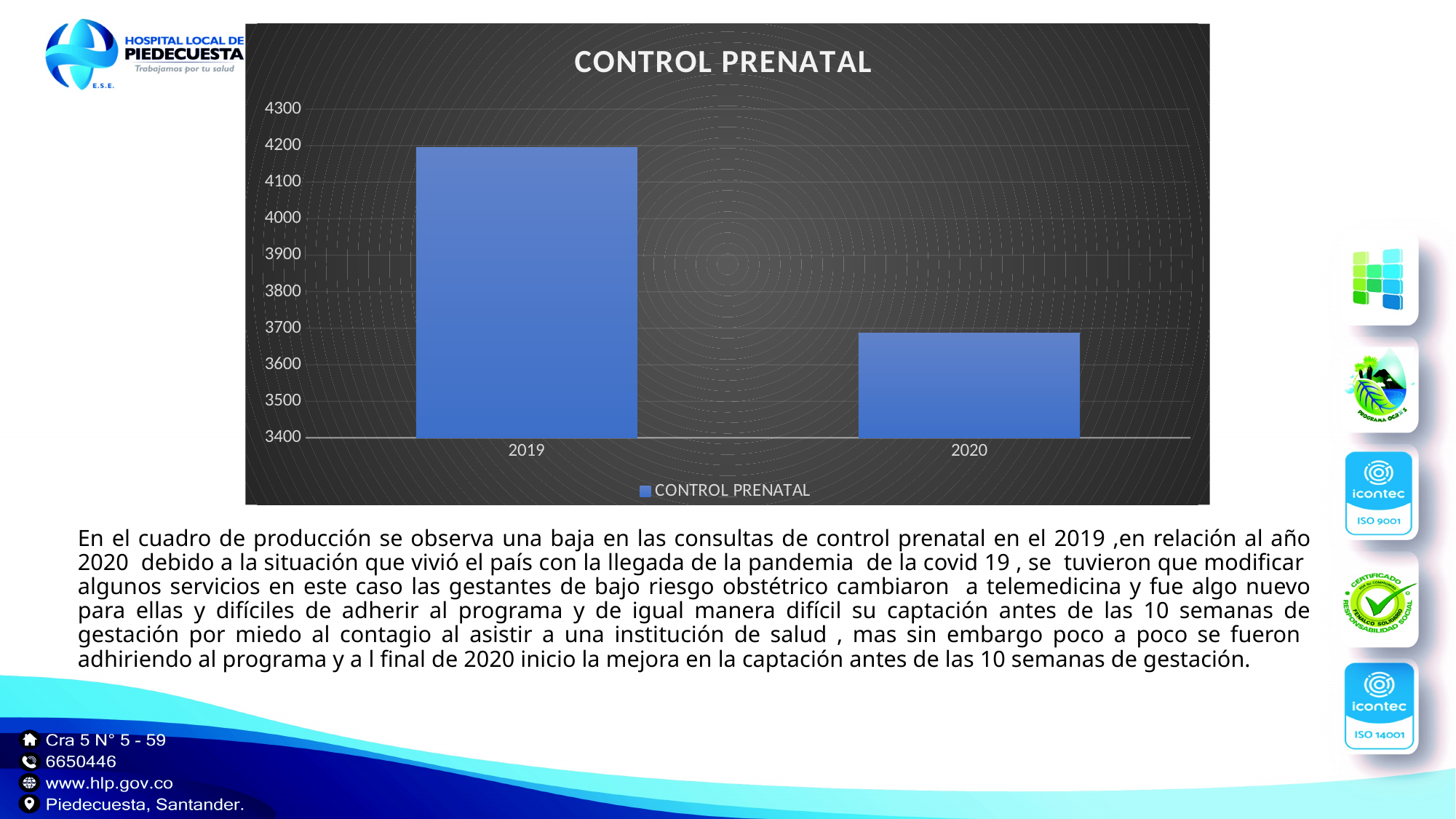
Which year has the lowest value in the chart? 2020 Is the value for 2019 greater or less than 4300? less Is the value for 2020 greater or less than 3800? less Is the value for 2019 greater or less than 4100? greater How many series does the chart legend list? 1 What is the title of the chart? CONTROL PRENATAL Which year has the highest value in the chart? 2019 What type of chart is shown on the slide? bar chart How many categories are shown on the x axis of the chart? 2 Do the values rise or fall from 2019 to 2020? fall Which is larger, the value for 2019 or the value for 2020? 2019